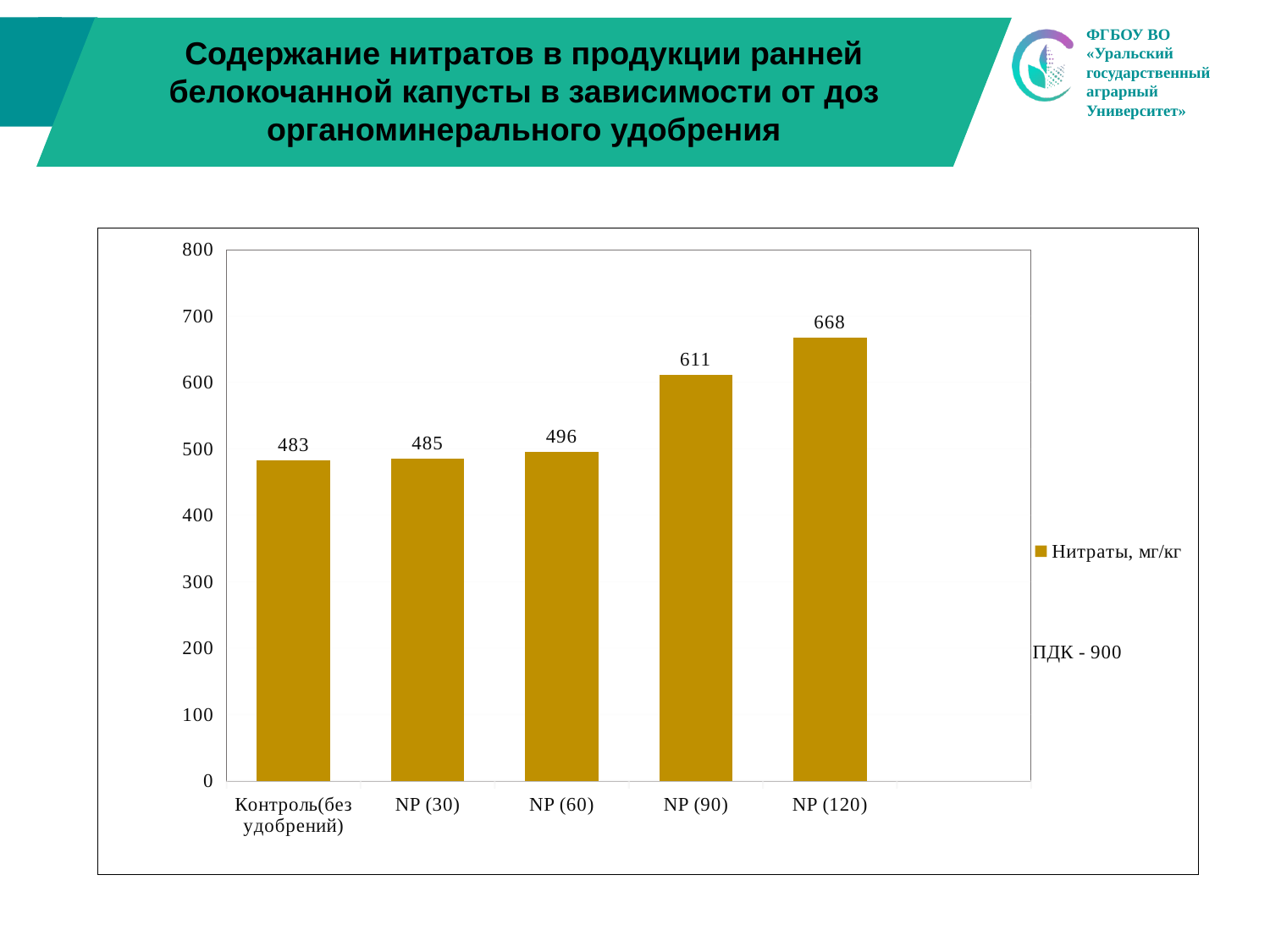
How many categories are shown on the x axis? 5 Which category has the lowest nitrate value? Контроль (без удобрений) What is the nitrate value for NP (90)? 611 What kind of chart is shown on the slide? bar chart Do the values rise or fall from the control to NP (120)? rise What is the value shown for NP (120)? 668 Is the value for NP (120) greater or less than 700? less Which is larger, the value for NP (90) or the value for NP (60)? NP (90) What is the difference between the values for NP (60) and the control? 13 What is the nitrate value for the control (Контроль (без удобрений)) bar? 483 Which category has the highest nitrate value? NP (120) What is the difference between the values for NP (120) and NP (90)? 57